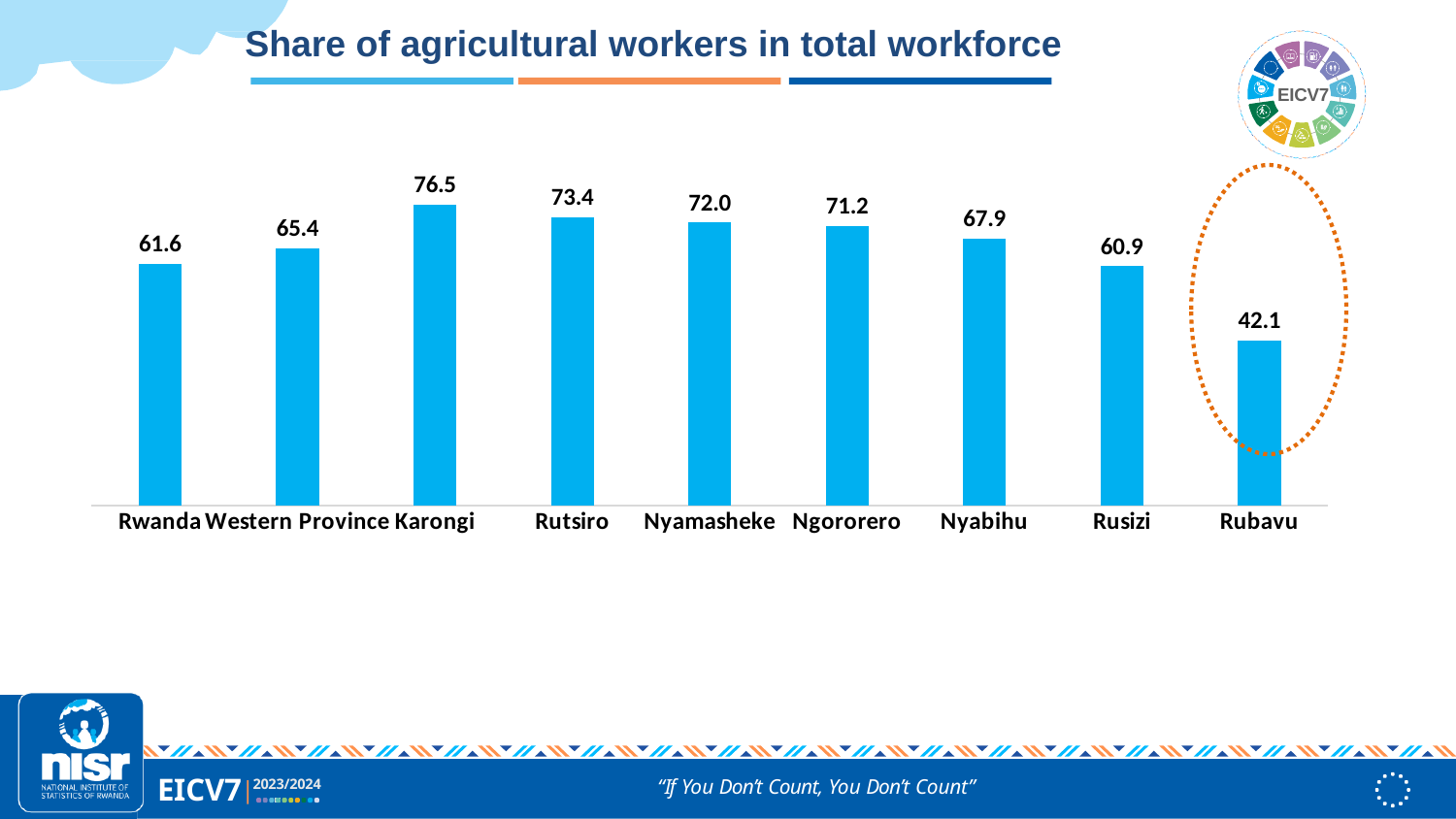
What kind of chart is shown on the slide? Bar chart Which category has the lowest share of agricultural workers? Rubavu What is the difference between the values for Western Province and Rwanda? 3.8 What is the value shown for Rubavu? 42.1 Which has a larger value, Rutsiro or Nyabihu? Rutsiro Which category has the highest share of agricultural workers? Karongi What is the value shown for Western Province? 65.4 What is the difference between the values for Karongi and Rubavu? 34.4 What is the share of agricultural workers in the total workforce for Karongi? 76.5 What is the title of the chart? Share of agricultural workers in total workforce What is the value shown for Rwanda? 61.6 How many categories are shown on the chart? 9